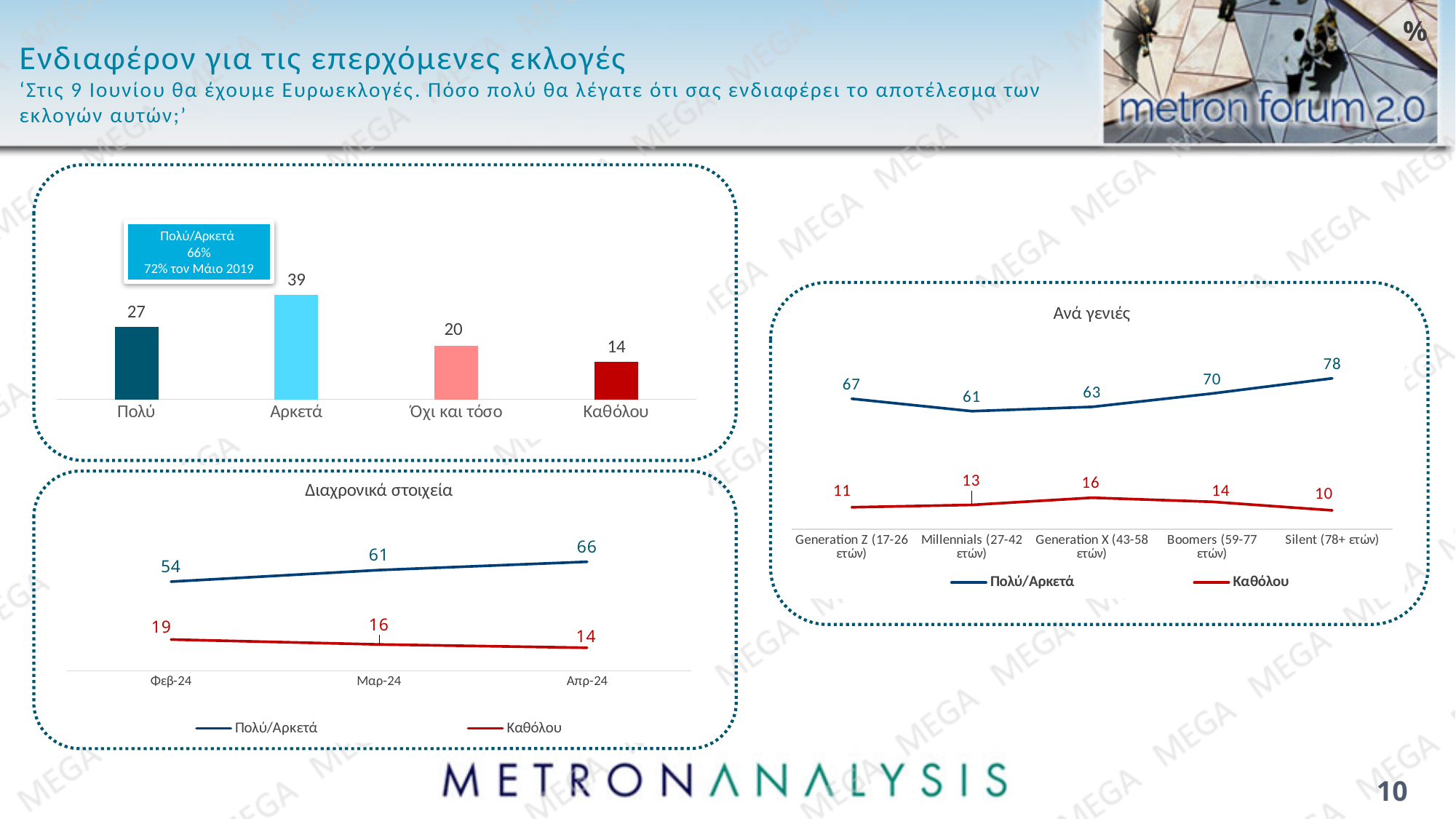
In the 'Διαχρονικά στοιχεία' chart, what is the value of Πολύ/Αρκετά for Μαρ-24? 61 In the top-left bar chart, which category has the lowest value? Καθόλου In the 'Ανά γενιές' chart, what is the difference between the Πολύ/Αρκετά and Καθόλου values for Generation Z (17-26 ετών)? 56 In the top-left bar chart, how many categories are shown? 4 In the top-left bar chart, what is the value for Αρκετά? 39 In the 'Διαχρονικά στοιχεία' chart, does the Καθόλου series rise or fall from Φεβ-24 to Απρ-24? Fall In the top-left bar chart, what is the difference between the values for Πολύ and Όχι και τόσο? 7 What kind of chart is the top-left chart on the slide? Bar chart In the 'Ανά γενιές' chart, which generation has the highest Πολύ/Αρκετά value? Silent (78+ ετών) In the 'Ανά γενιές' chart, which is larger: the Καθόλου value for Generation X (43-58 ετών) or for Millennials (27-42 ετών)? Generation X (43-58 ετών) In the 'Ανά γενιές' chart, what is the Πολύ/Αρκετά value for Boomers (59-77 ετών)? 70 In the 'Διαχρονικά στοιχεία' chart, how many series does the legend list? 2